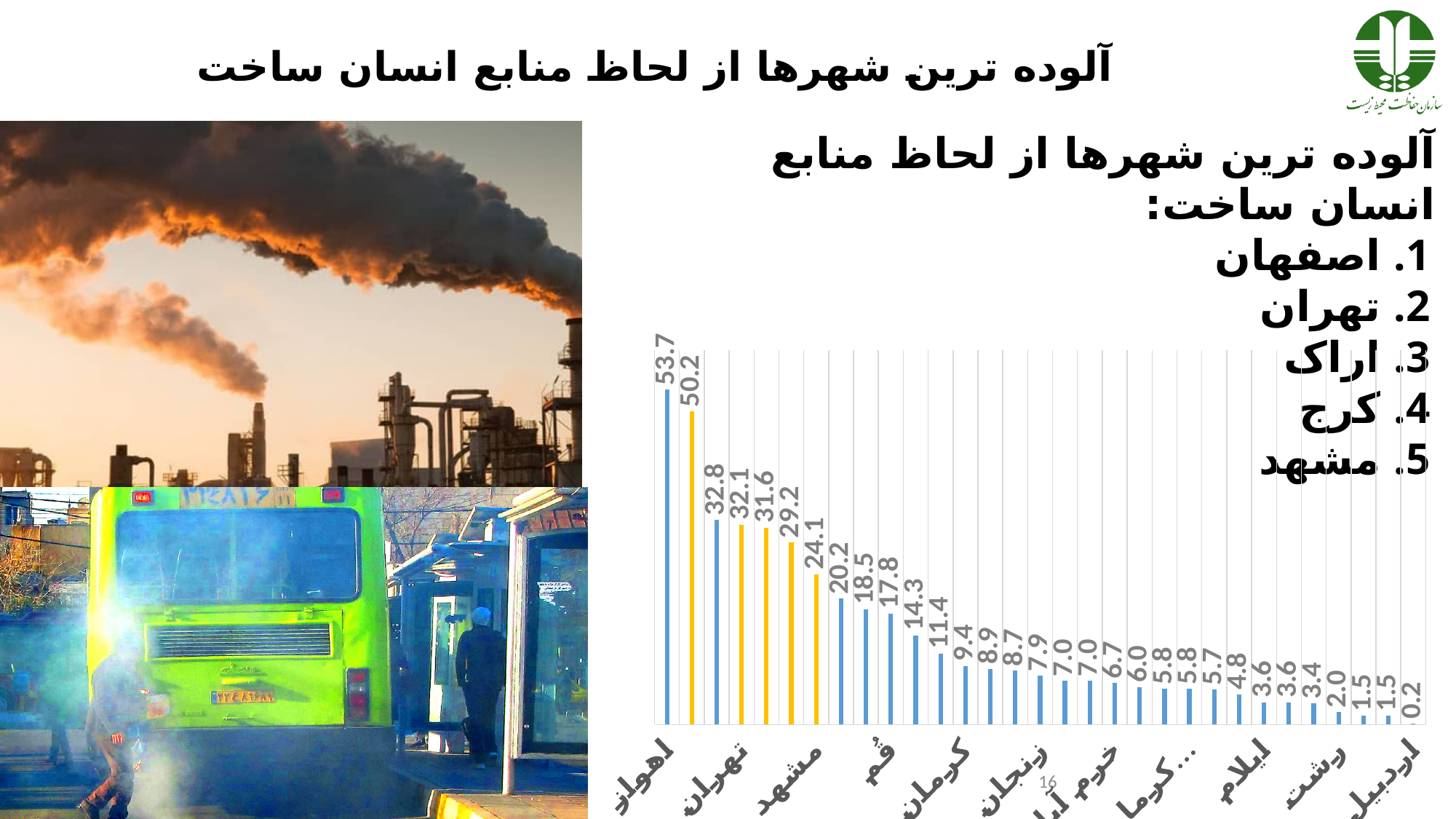
How many bars are plotted in the chart? 31 What kind of chart is shown on the slide? bar chart Which is larger, the value for اهواز or the value for تهران? اهواز Do the values rise or fall from left to right along the x axis? fall What is the difference between the values for اهواز and اردبیل? 53.5 Which city has the highest value in the chart? اهواز What is the value for تهران? 32.1 What is the value for اهواز? 53.7 What is the value for قم? 17.8 What is the value for اردبیل? 0.2 What is the value for مشهد? 24.1 Which city has the lowest value in the chart? اردبیل